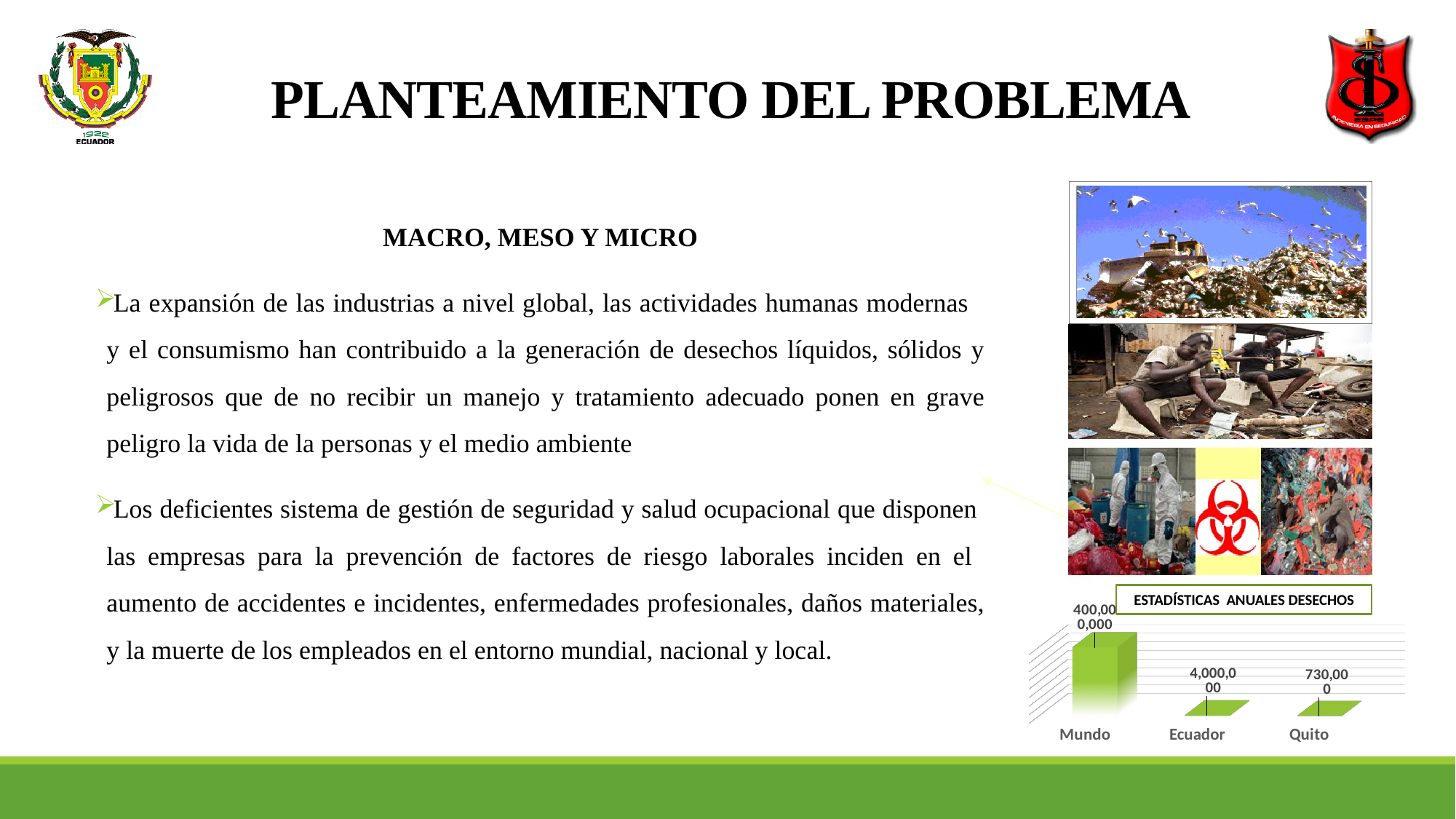
What is the difference between the values for Ecuador and Quito in the chart? 3,270,000 What is the value for Ecuador in the chart? 4,000,000 What is the value for Mundo in the chart? 400,000,000 Do the values in the chart rise or fall from Mundo to Quito along the x axis? fall Which category has the highest value in the chart? Mundo What is the title of the chart on the slide? ESTADÍSTICAS ANUALES DESECHOS Which is larger in the chart, the value for Ecuador or the value for Quito? Ecuador What is the difference between the values for Mundo and Ecuador in the chart? 396,000,000 Which category has the lowest value in the chart? Quito What type of chart is shown on the slide? bar chart How many categories are shown in the chart? 3 What is the value for Quito in the chart? 730,000